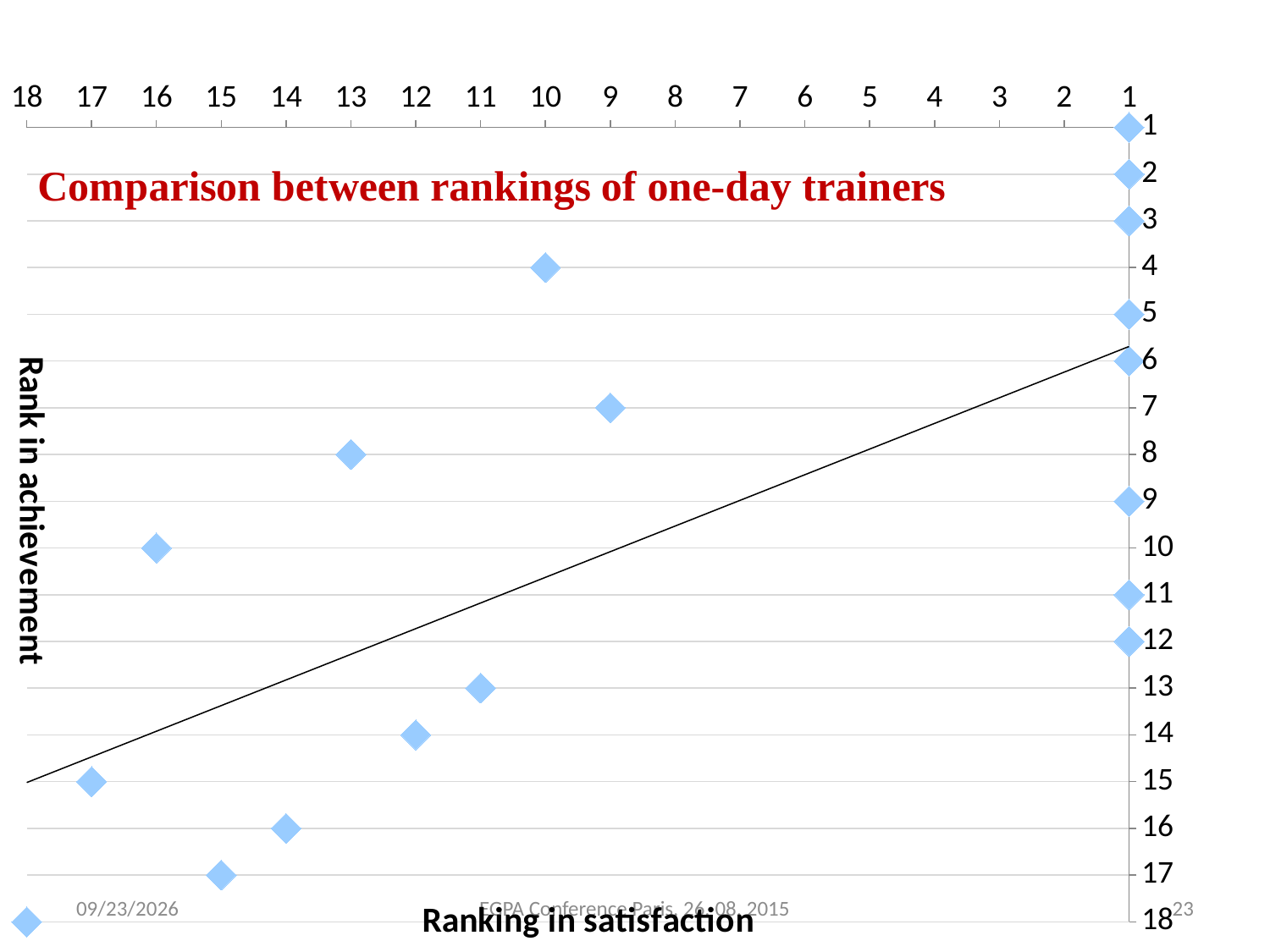
What is the ranking in satisfaction of the trainer with rank 15 in achievement? 17 How many data points have a ranking in satisfaction of 1? 8 Does the straight trendline rise or fall from left to right across the chart? rises Which has the larger ranking in satisfaction number: the trainer ranked 7 in achievement or the trainer ranked 16 in achievement? the trainer ranked 16 in achievement What is the ranking in satisfaction of the trainer with rank 10 in achievement? 16 What is the title of the chart? Comparison between rankings of one-day trainers What is the ranking in satisfaction of the trainer with rank 8 in achievement? 13 What is the label of the horizontal axis? Ranking in satisfaction What is the ranking in satisfaction of the trainer with rank 4 in achievement? 10 How many data points are plotted on the chart? 18 What kind of chart is shown on the slide? scatter chart What is the ranking in satisfaction of the trainer with rank 18 in achievement? 18